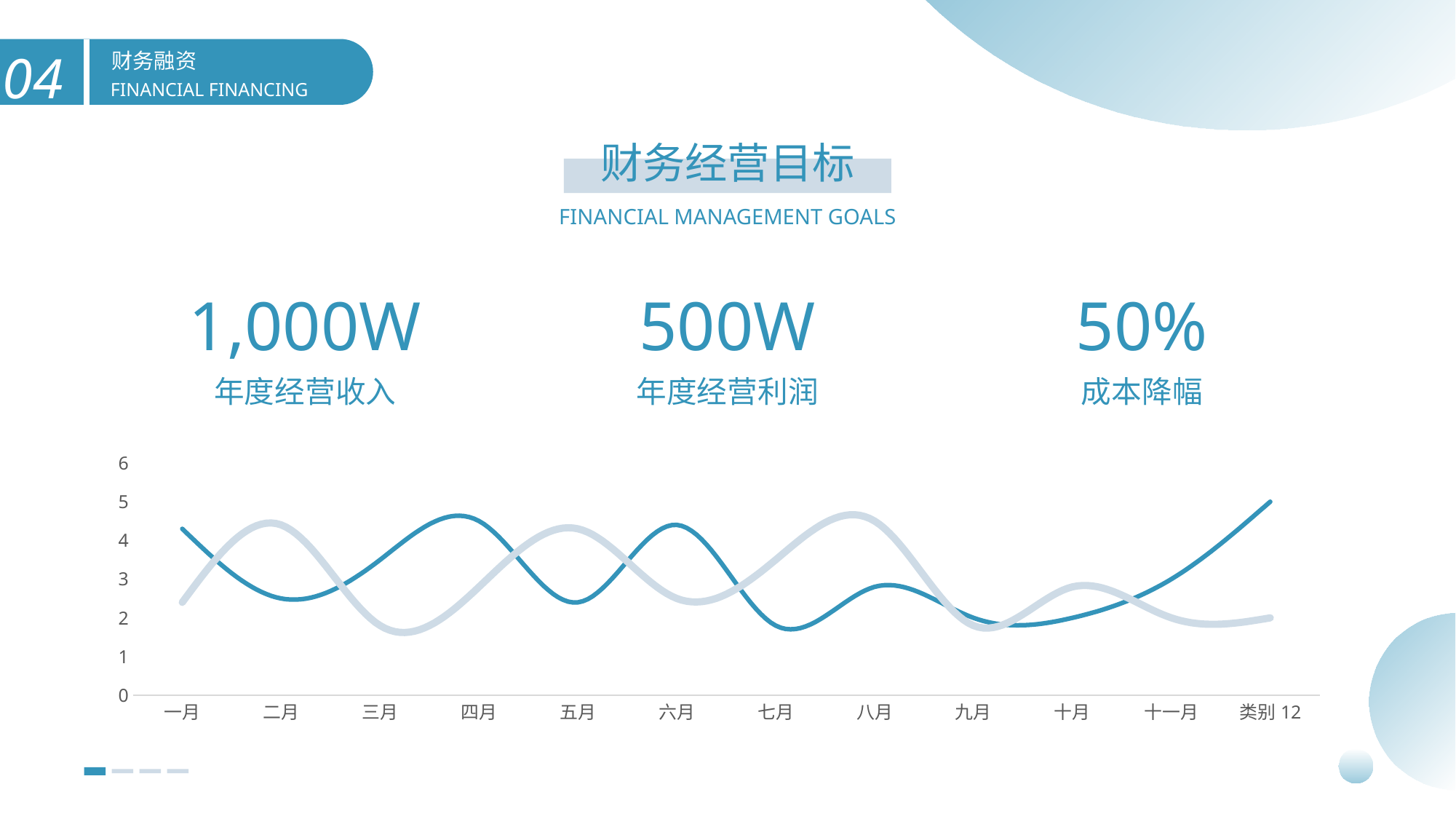
How many categories are shown on the x axis of the chart? 12 What is the label of the last category on the x axis of the chart? 类别 12 At 类别 12, which line has the higher value, the dark blue line or the light grey line? the dark blue line Is the value of the dark blue line for 四月 greater or less than 4? greater Is the value of the light grey line for 八月 greater or less than 4? greater What kind of chart is shown at the bottom of the slide? line chart At 二月, which line has the higher value, the dark blue line or the light grey line? the light grey line Does the dark blue line rise or fall from 十月 to 类别 12? rise How many lines are plotted in the chart? 2 Is the value of the dark blue line for 七月 greater or less than 3? less